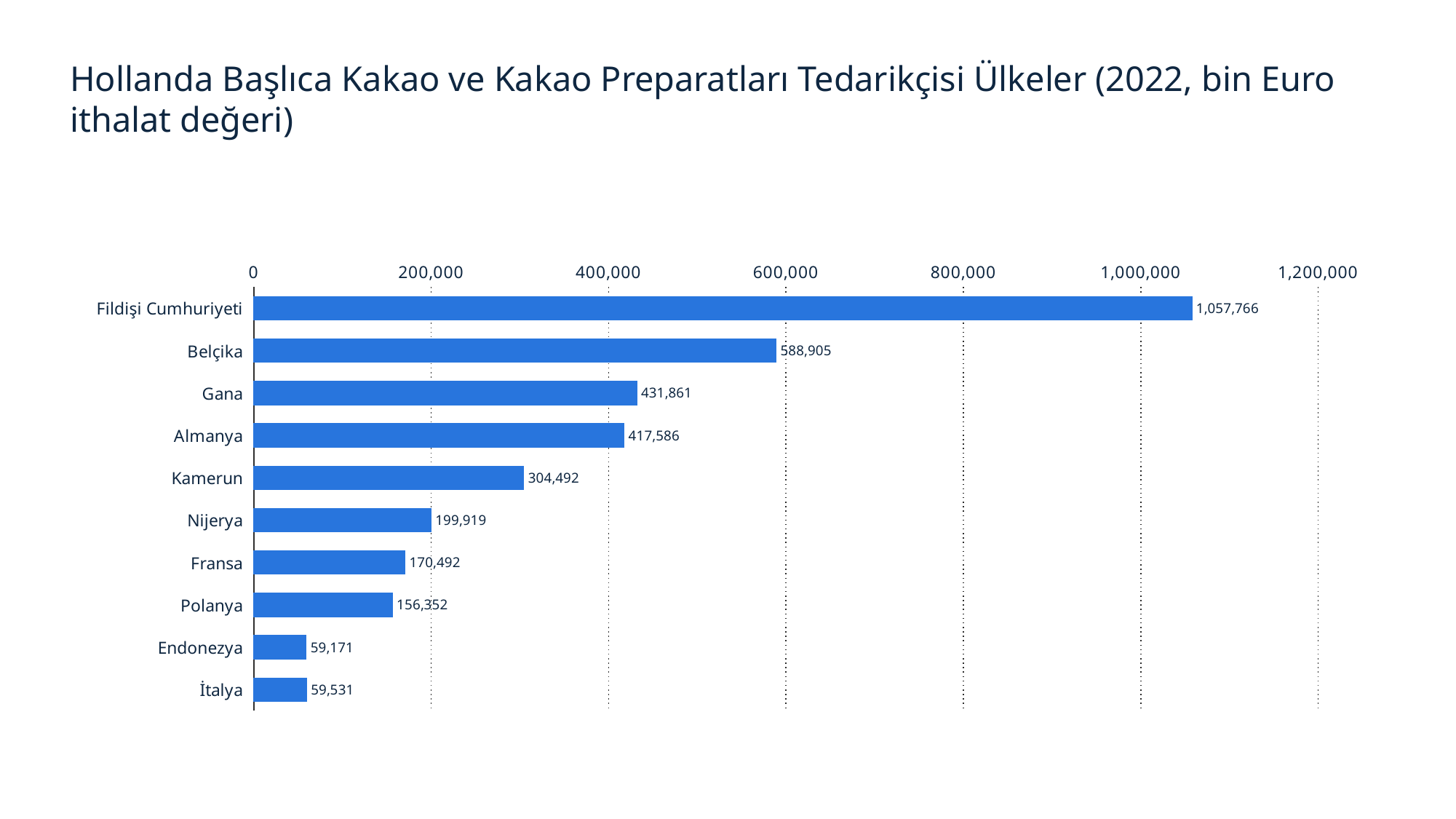
What is the value for Polanya? 156,352 What is the value for Fildişi Cumhuriyeti? 1,057,766 What year does the chart title say the data is for? 2022 How many countries are shown in the chart? 10 What kind of chart is shown on the slide? Bar chart What is the difference between the values for Nijerya and Fransa? 29,427 What is the value for Kamerun? 304,492 Is the value for Kamerun greater or less than 200,000? greater Which has a larger value, Gana or Almanya? Gana Which country has the highest value? Fildişi Cumhuriyeti What is the difference between the values for Belçika and Gana? 157,044 Which country has the lowest value? Endonezya